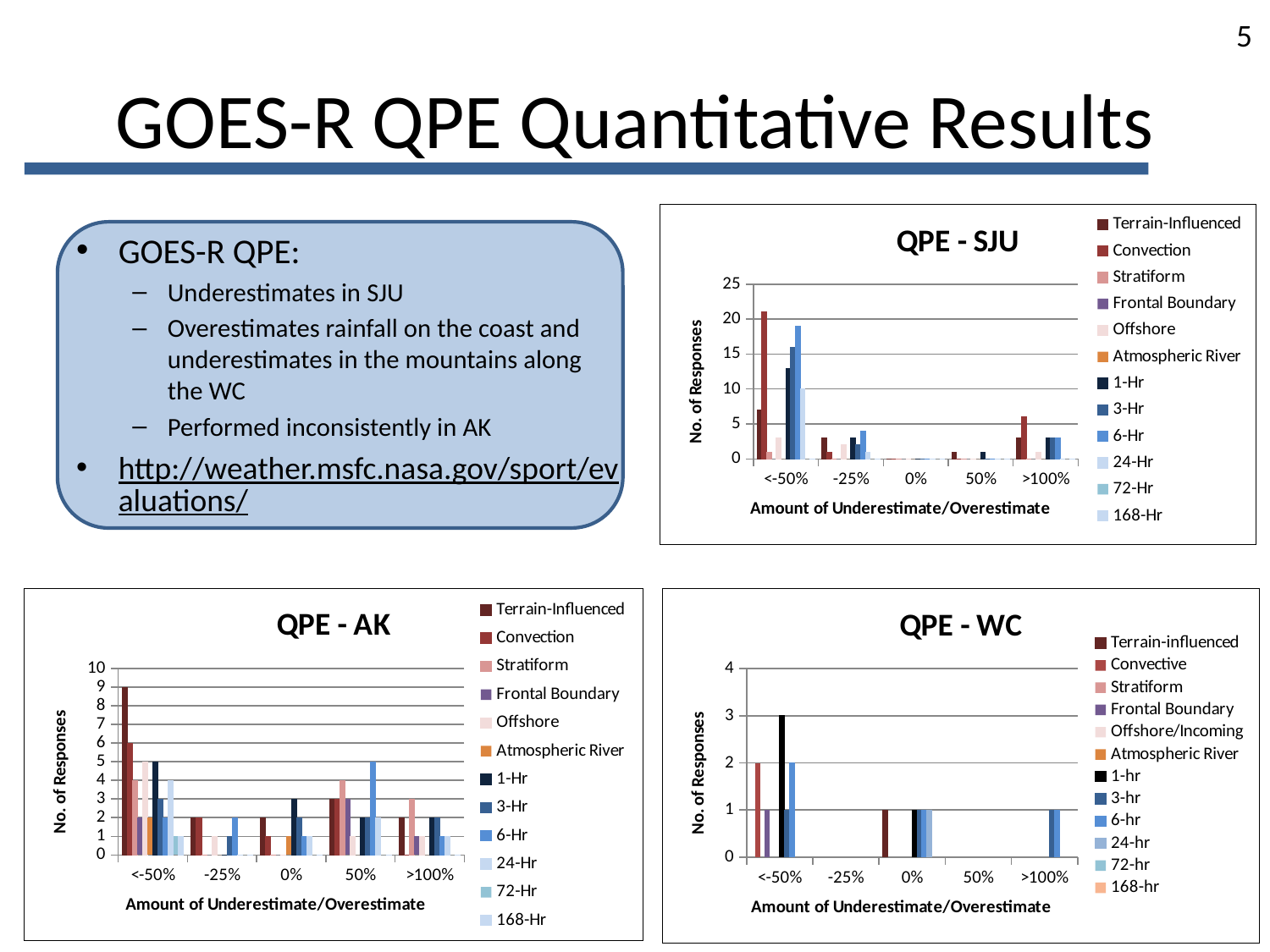
In the QPE - SJU chart, how many categories are shown on the x axis? 5 What kind of chart is the QPE - SJU chart? bar chart In the QPE - WC chart, which is larger at <-50%: 1-hr or 6-hr? 1-hr In the QPE - SJU chart, is the value for Convection at <-50% greater or less than 15? greater In the QPE - SJU chart, is the value for 1-Hr at <-50% greater or less than 10? greater In the QPE - SJU chart, how many series does the legend list? 12 In the QPE - AK chart, which x-axis category contains the tallest bar? <-50% In the QPE - WC chart, what is the number of responses for 1-hr at <-50%? 3 In the QPE - AK chart, what is the difference between Terrain-Influenced and Convection at <-50%? 3 In the QPE - AK chart, what is the number of responses for 6-Hr at 50%? 5 In the QPE - AK chart, what is the number of responses for Terrain-Influenced at <-50%? 9 In the QPE - WC chart, what is the label of the y axis? No. of Responses